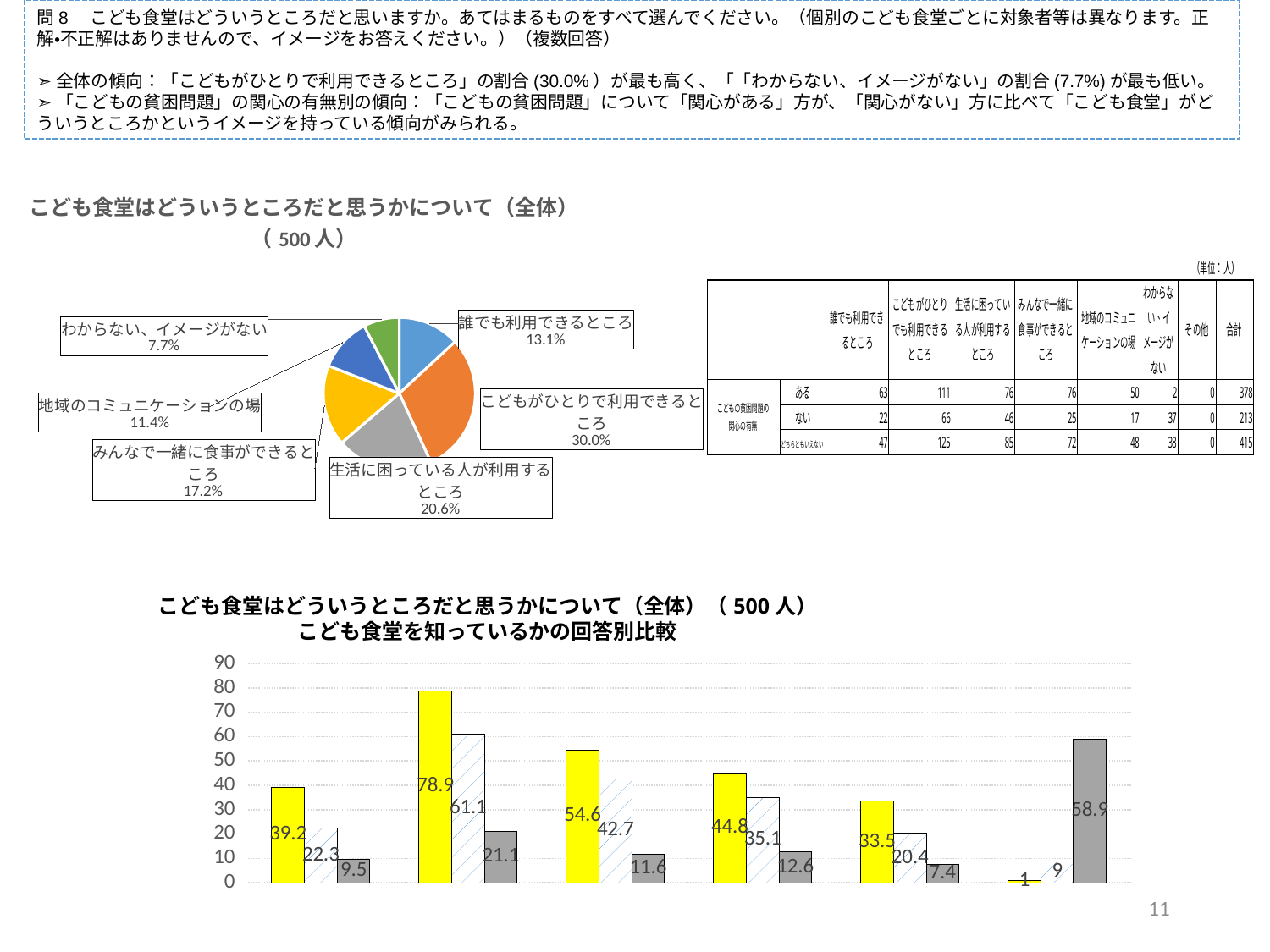
In the pie chart, which category has the largest share? こどもがひとりで利用できるところ In the pie chart, what percentage is shown for 「みんなで一緒に食事ができるところ」? 17.2% How many slices does the pie chart have? 6 In the pie chart, which category has the smallest share? わからない、イメージがない In the bottom bar chart, what is the highest value labeled on any bar? 78.9 In the pie chart, what percentage is shown for 「地域のコミュニケーションの場」? 11.4% In the pie chart, what is the difference in percentage points between 「生活に困っている人が利用するところ」 and 「みんなで一緒に食事ができるところ」? 3.4 In the bottom bar chart, how many groups of bars are there? 6 In the pie chart, what percentage is shown for 「こどもがひとりで利用できるところ」? 30.0% In the pie chart, which is larger: 「誰でも利用できるところ」 or 「地域のコミュニケーションの場」? 誰でも利用できるところ What kind of chart is the chart at the top left of the slide? Pie chart What kind of chart is the chart at the bottom of the slide? Bar chart